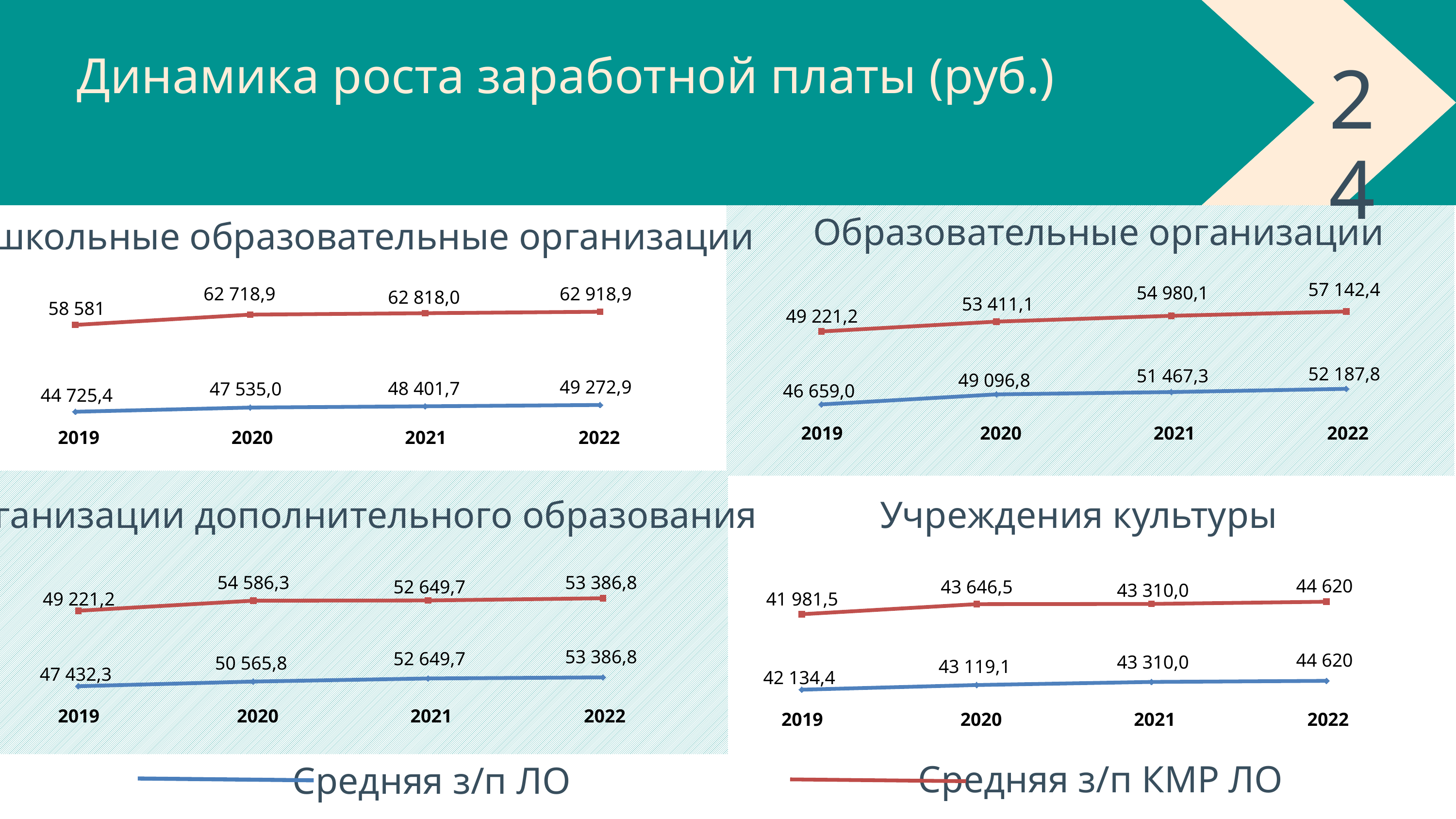
In the chart titled "Образовательные организации" (top right), what is the value of "Средняя з/п КМР ЛО" for 2022? 57 142,4 How many series does the legend at the bottom of the slide list? 2 In the bottom-left chart, in which year is "Средняя з/п КМР ЛО" highest? 2020 In the bottom-left chart, what is the value of "Средняя з/п ЛО" for 2021? 52 649,7 In the chart titled "Учреждения культуры" (bottom right), which series has the larger value in 2019, "Средняя з/п ЛО" or "Средняя з/п КМР ЛО"? Средняя з/п ЛО In the top-left chart, does "Средняя з/п ЛО" rise or fall from 2019 to 2022? rise In the chart titled "Образовательные организации" (top right), in which year is "Средняя з/п ЛО" lowest? 2019 In the top-left chart, what is the value of "Средняя з/п КМР ЛО" for 2020? 62 718,9 How many years are shown on the x axis of the chart titled "Учреждения культуры" (bottom right)? 4 What type of chart is the chart titled "Образовательные организации" (top right)? line chart In the chart titled "Учреждения культуры" (bottom right), what is the value of "Средняя з/п ЛО" for 2019? 42 134,4 In the chart titled "Образовательные организации" (top right), what is the difference between "Средняя з/п КМР ЛО" and "Средняя з/п ЛО" in 2022? 4 954,6